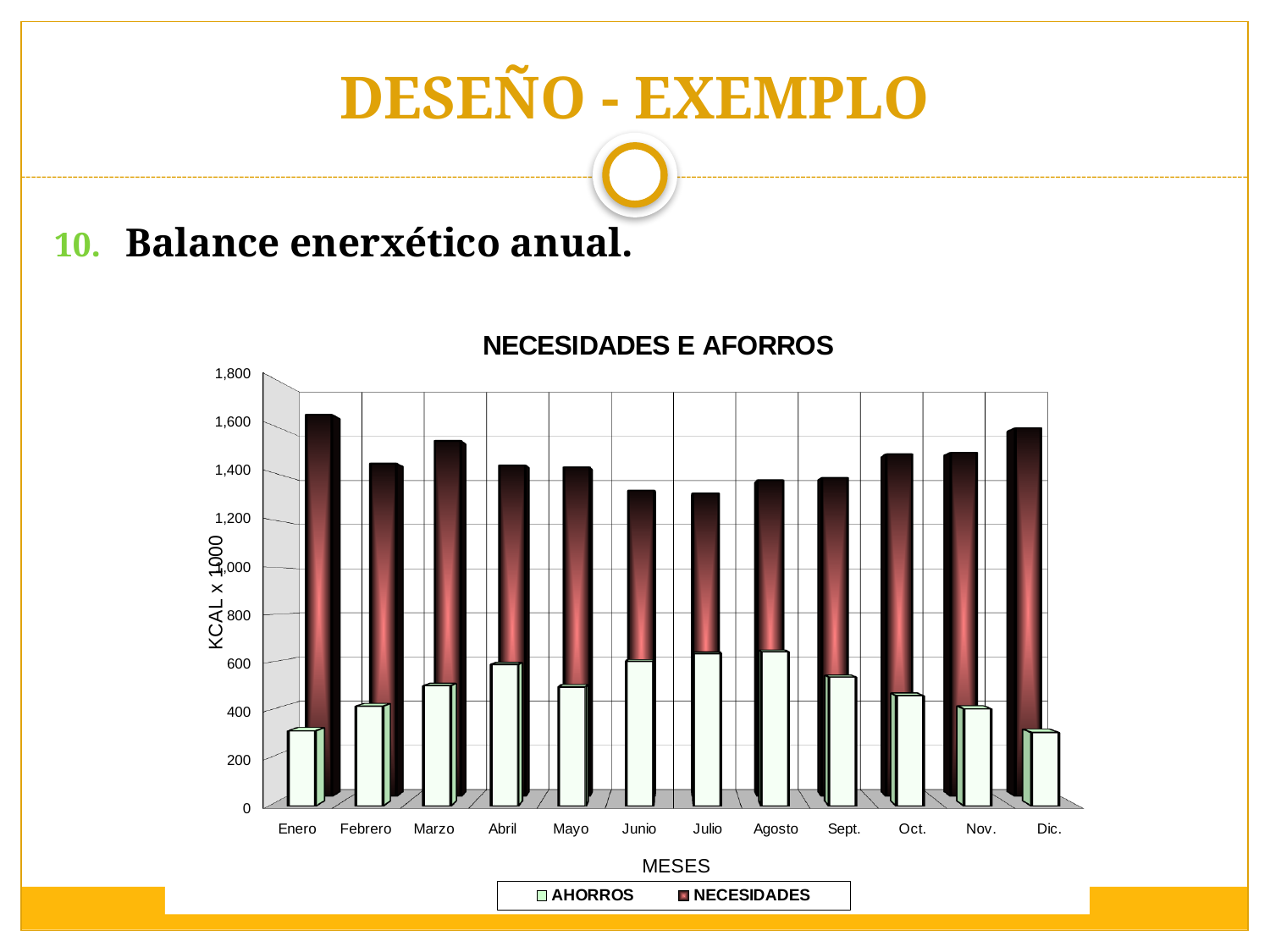
What is the label of the vertical axis? KCAL x 1000 Is the NECESIDADES value for Enero greater or less than 1,400? greater Is the AHORROS value for Agosto greater or less than 600? greater How many series does the legend list? 2 Which is larger, the NECESIDADES value for Enero or for Febrero? Enero Is the AHORROS value for Enero greater or less than 400? less What type of chart is shown on the slide? bar chart Do the NECESIDADES values rise or fall from Enero to Julio? fall How many months are shown on the x axis? 12 Which month has the highest NECESIDADES value? Enero What is the title of the chart? NECESIDADES E AFORROS